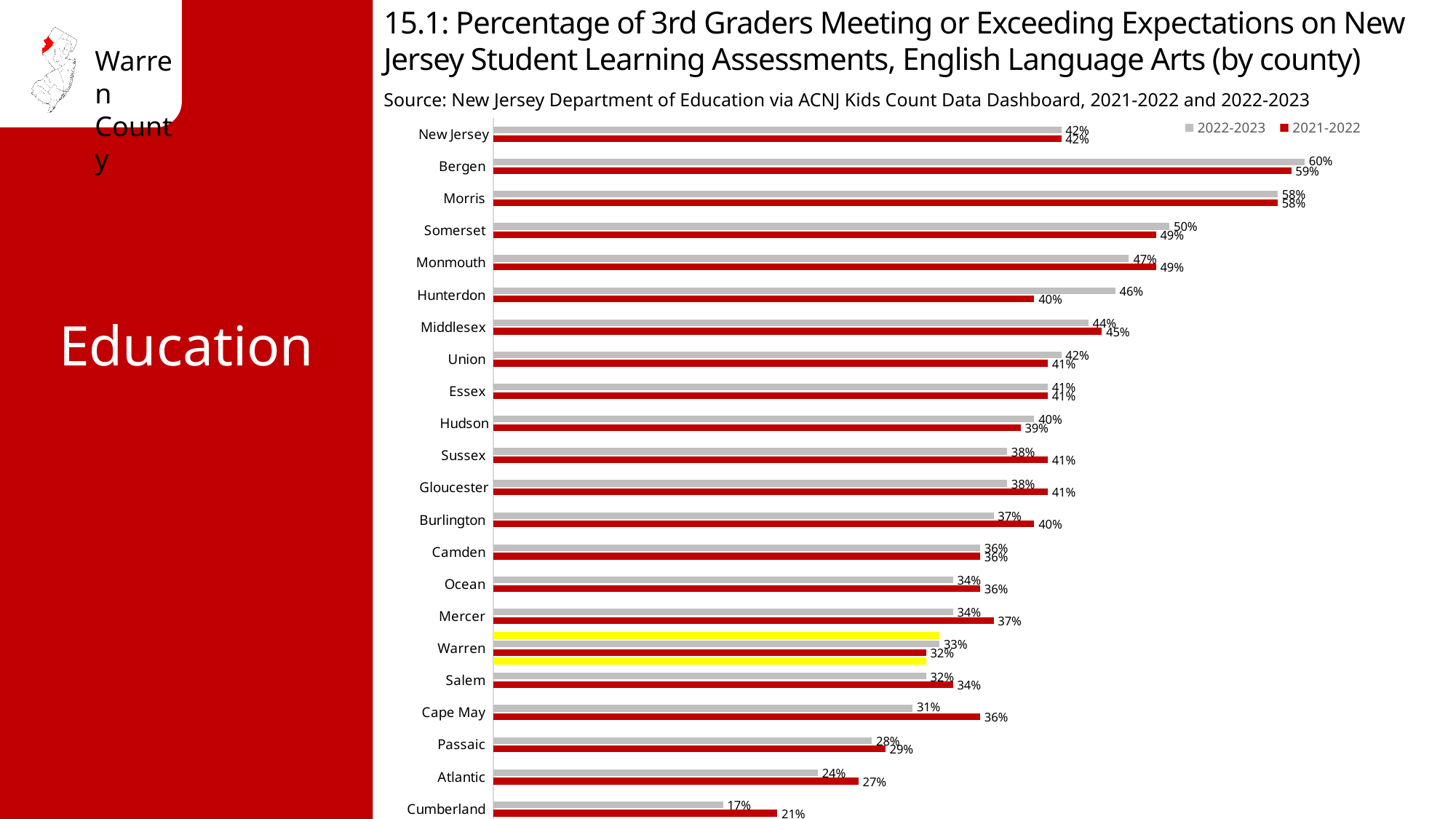
Which county has the highest 2022-2023 value? Bergen What is the 2022-2023 value for Warren? 33% What is the difference between the 2022-2023 and 2021-2022 values for Hunterdon? 6% What is the 2021-2022 value for Hunterdon? 40% For Cape May, which is larger: the 2022-2023 value or the 2021-2022 value? 2021-2022 Which is larger: Monmouth's 2022-2023 value or Somerset's 2022-2023 value? Somerset What kind of chart is shown on the slide? Bar chart How many series does the legend list? 2 Which county has the lowest 2021-2022 value? Cumberland What is the difference between Bergen's and Cumberland's 2022-2023 values? 43% What is the 2022-2023 value for Cape May? 31% How many counties or regions are listed on the chart? 22